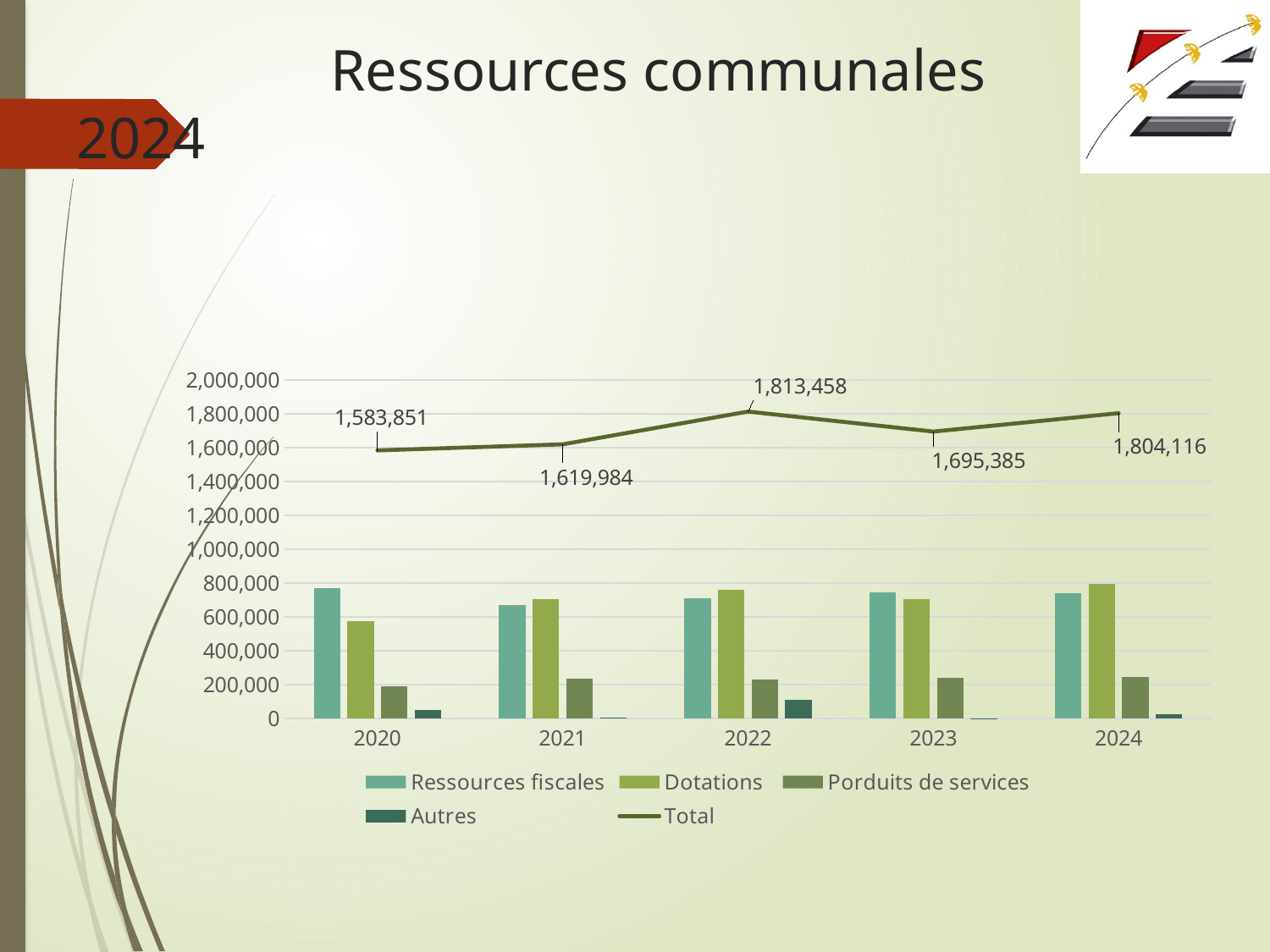
How many series does the legend list? 5 What is the Total for 2023? 1,695,385 Is the value for Ressources fiscales in 2020 greater or less than 600,000? greater What is the Total for 2020? 1,583,851 What is the difference between the Total for 2024 and the Total for 2023? 108,731 Which is larger, the Total for 2021 or the Total for 2023? 2023 Does the Total rise or fall from 2020 to 2022? rise How many years are shown on the x axis? 5 What is the Total for 2022? 1,813,458 In which year is the Total highest? 2022 Is the value for Porduits de services in 2021 greater or less than 400,000? less In which year is the Total lowest? 2020